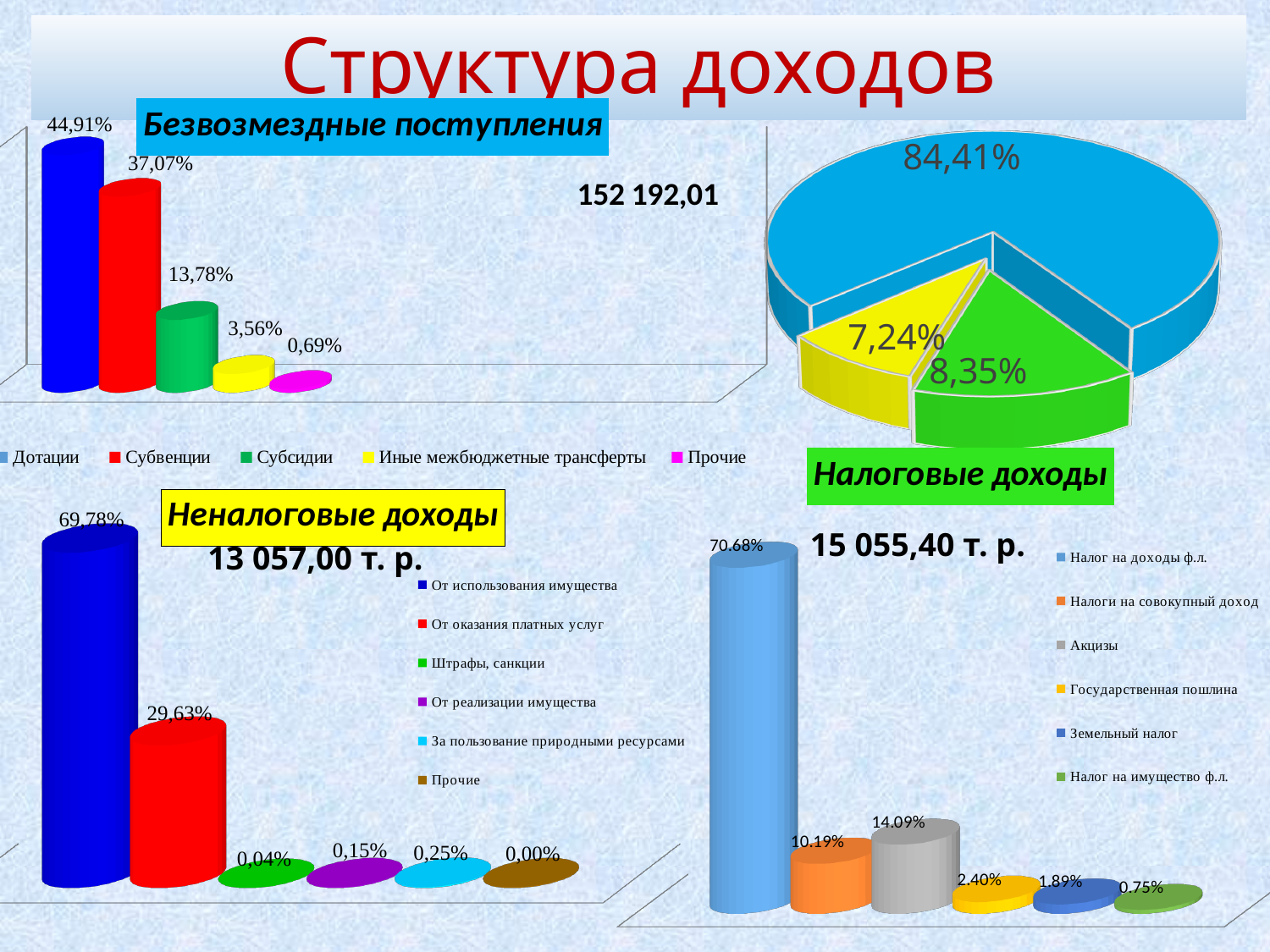
In the Налоговые доходы pie chart, what is the value of the largest slice? 84,41% In the Неналоговые доходы bar chart, what is the value for От оказания платных услуг? 29,63% What kind of chart is the Налоговые доходы chart in the top right? pie chart In the Налоговые доходы pie chart, what is the value of the smallest slice? 7,24% In the Безвозмездные поступления bar chart, what is the difference between Дотации and Субвенции? 7,84% In the Неналоговые доходы bar chart, which category has the highest value? От использования имущества In the Безвозмездные поступления bar chart, what is the value for Субсидии? 13,78% In the bottom-right bar chart, which is larger: Налоги на совокупный доход or Акцизы? Акцизы In the bottom-right bar chart, what is the value for Акцизы? 14.09% How many series does the legend of the Безвозмездные поступления bar chart list? 5 In the Безвозмездные поступления bar chart, what is the value for Дотации? 44,91% In the Безвозмездные поступления bar chart, which category has the lowest value? Прочие